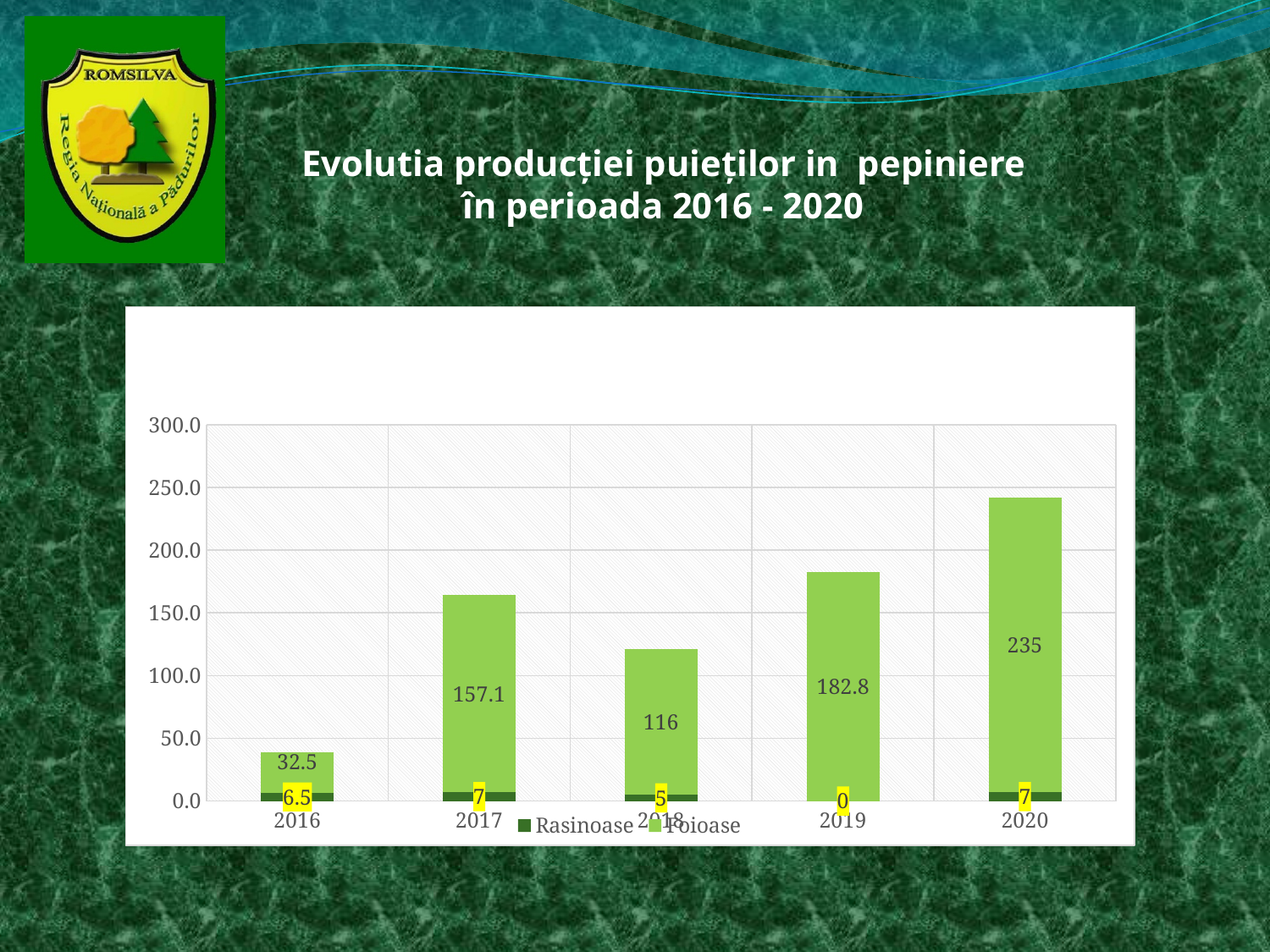
What is the Rasinoase value for 2016? 6.5 What is the Rasinoase value for 2019? 0 How many years are shown on the x axis? 5 What is the Foioase value for 2017? 157.1 What is the total of the stacked bar for 2018? 121 Which is larger, the Foioase value for 2017 or for 2018? 2017 Which year has the highest Foioase value? 2020 What is the difference between the Foioase values for 2020 and 2019? 52.2 What kind of chart is shown on the slide? Stacked bar chart How many series does the legend list? 2 Which year has the lowest Foioase value? 2016 What is the Foioase value for 2020? 235